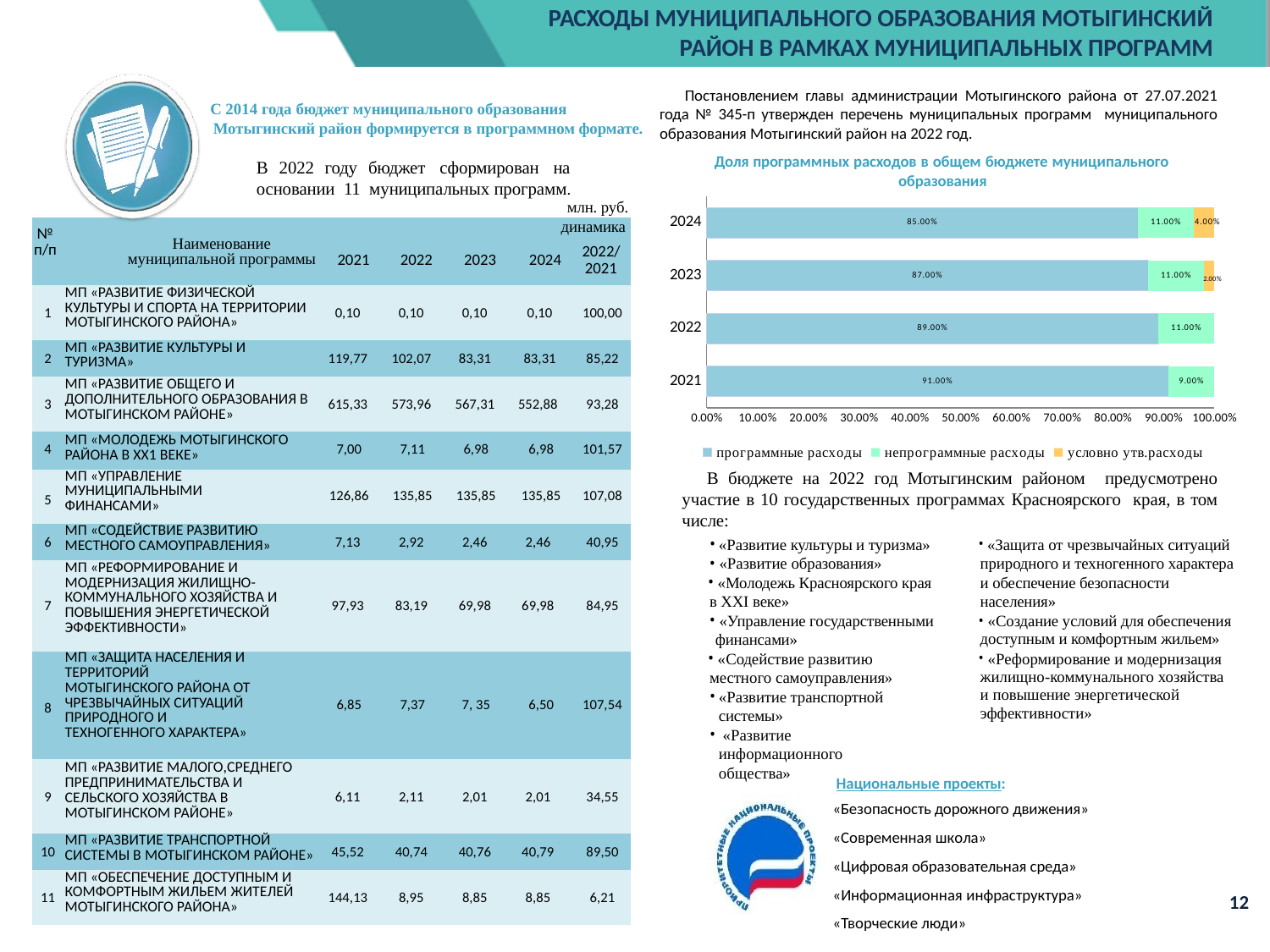
What kind of chart is shown on the slide? Stacked bar chart How many years (categories) are shown in the chart? 4 Which year has the highest value of программные расходы? 2021 What is the value of программные расходы for 2021 in the chart? 91.00% What is the value of непрограммные расходы for 2022 in the chart? 11.00% What is the value of условно утв.расходы for 2023 in the chart? 2.00% Which is larger: непрограммные расходы in 2021 or in 2022? 2022 What is the difference between программные расходы in 2021 and in 2024? 6.00% What is the value of программные расходы for 2024 in the chart? 85.00% How many series does the chart legend list? 3 Does the share of программные расходы rise or fall from 2021 to 2024? Fall Which year has the lowest value of программные расходы? 2024